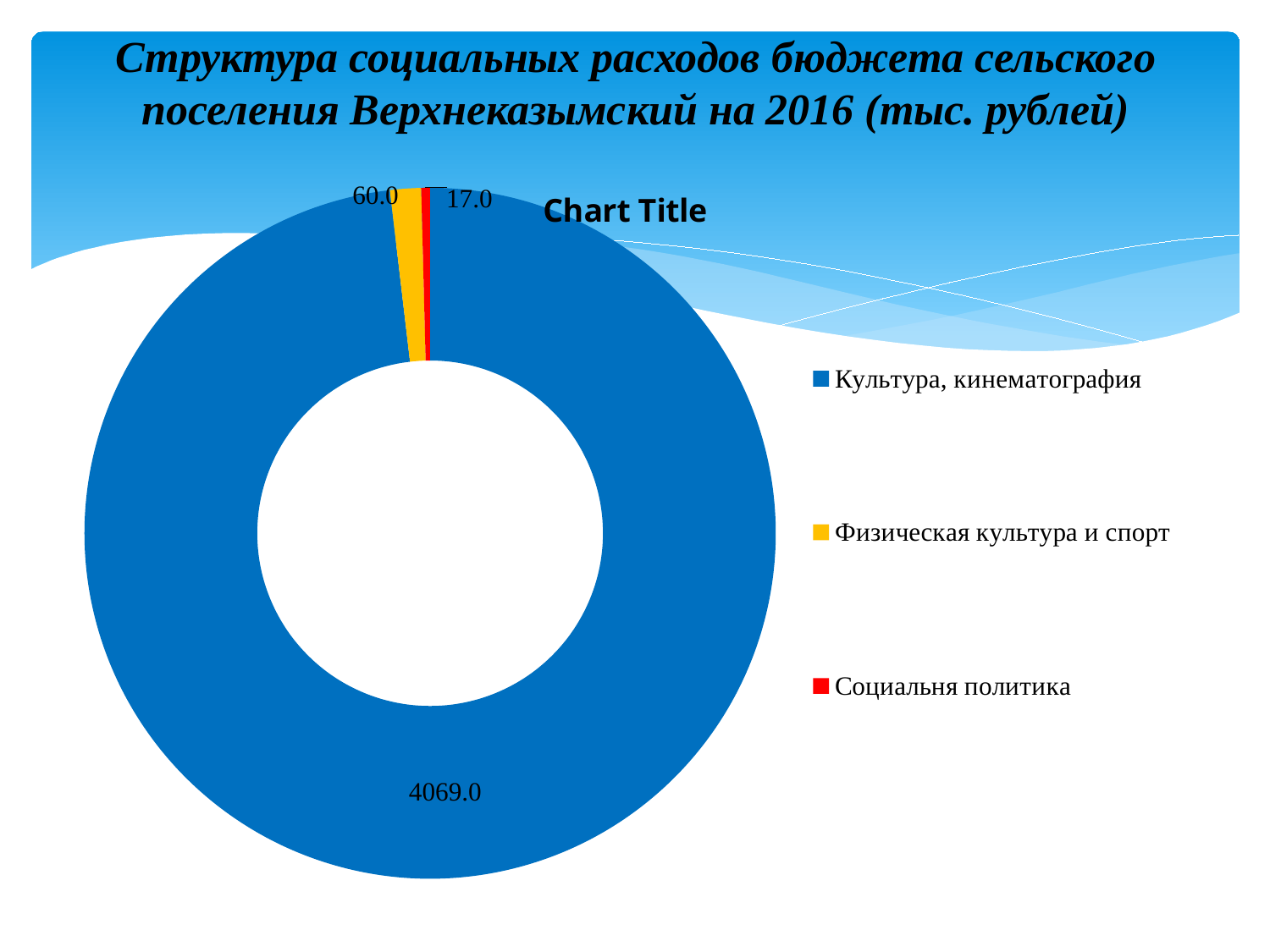
Which is larger, the value for Физическая культура и спорт or the value for Социальня политика? Физическая культура и спорт What kind of chart is shown on the slide? doughnut chart What is the value for Социальня политика? 17.0 Which colour represents Социальня политика in the legend? red What is the value for Физическая культура и спорт? 60.0 Which category has the largest value? Культура, кинематография Which category has the smallest value? Социальня политика What is the value for Культура, кинематография? 4069.0 What is the difference between the values for Физическая культура и спорт and Социальня политика? 43.0 What is the total of all three values shown in the chart? 4146.0 How many categories are shown in the chart? 3 What is the difference between the values for Культура, кинематография and Физическая культура и спорт? 4009.0